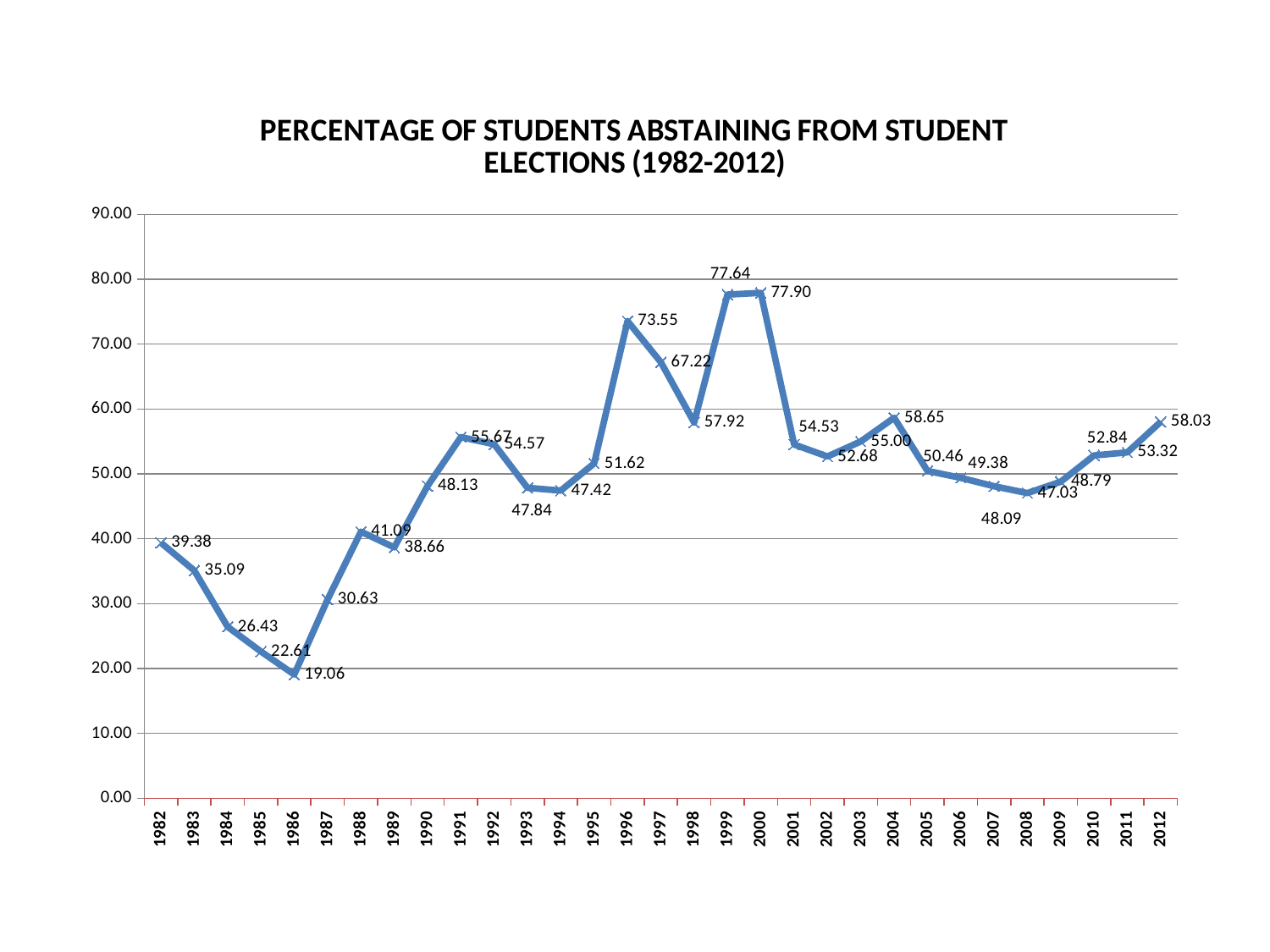
Which year has the lowest percentage of students abstaining? 1986 What is the title of the chart? PERCENTAGE OF STUDENTS ABSTAINING FROM STUDENT ELECTIONS (1982-2012) How many years are plotted on the chart? 31 Is the value for 1998 greater or less than 60.00? less What is the percentage of students abstaining in 2000? 77.90 What is the percentage of students abstaining in 1986? 19.06 What is the percentage of students abstaining in 2012? 58.03 Which year has the highest percentage of students abstaining? 2000 Which year has a higher percentage of students abstaining, 1991 or 1992? 1991 What is the difference between the percentage in 1996 and the percentage in 1997? 6.33 Do the values rise or fall from 1982 to 1986? fall What kind of chart is shown on the slide? line chart